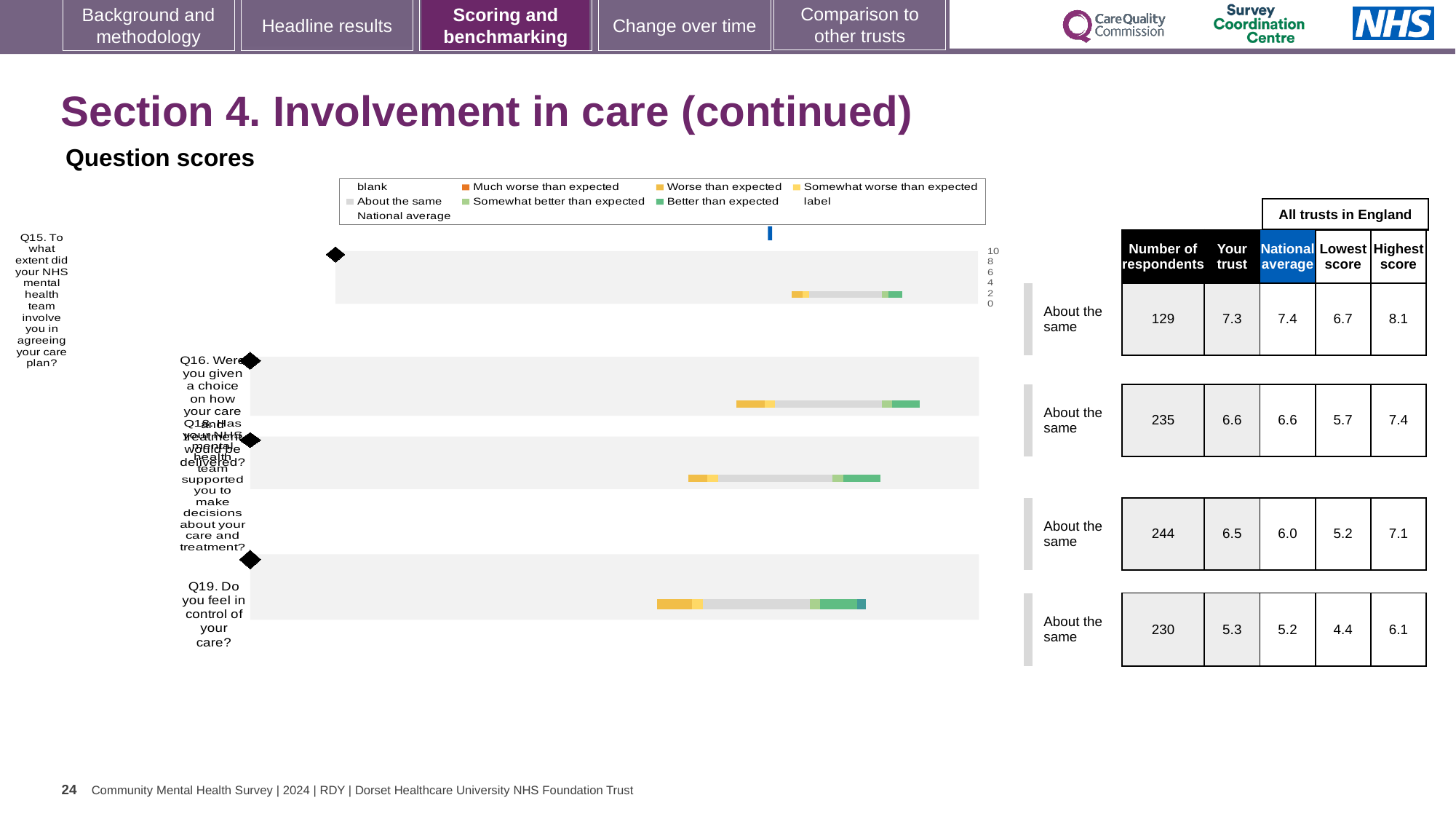
How many respondents answered Q16? 235 What is the national average score for Q15 (involvement in agreeing your care plan)? 7.4 What is the highest score among all trusts in England for Q19? 6.1 What kind of chart is used to show the question scores? bar chart What is the 'Your trust' score for Q19 (Do you feel in control of your care?)? 5.3 For Q18, what is the difference between the 'Your trust' score and the national average? 0.5 What benchmark category is shown for Q15? About the same Which question has the largest number of respondents? Q18 For Q18, which is larger: the 'Your trust' score or the national average? Your trust How many survey questions are plotted in the question scores chart? 4 Which question has the lowest 'Your trust' score? Q19 Which question has the highest 'Your trust' score? Q15